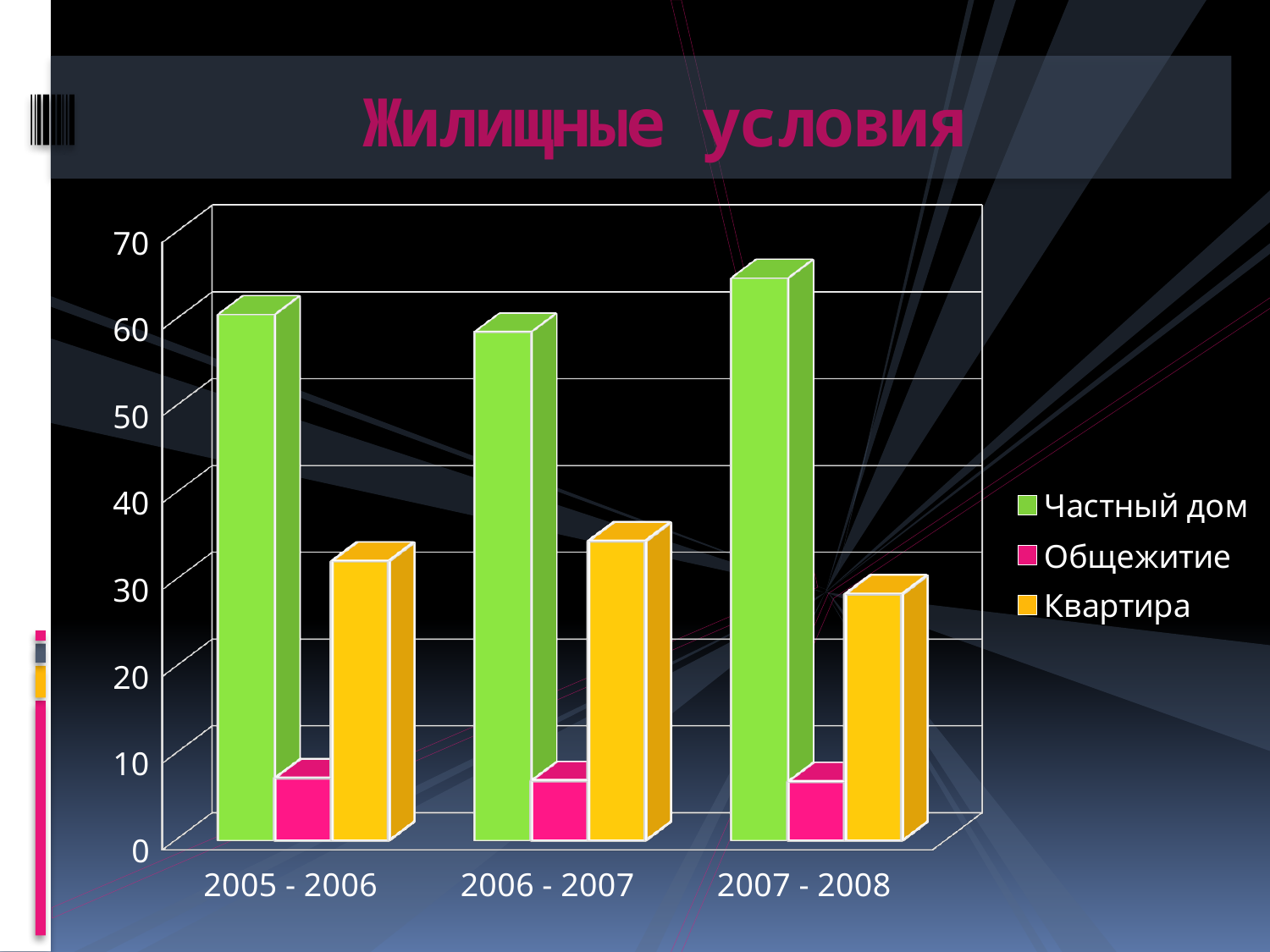
In which period is the value for Квартира the lowest? 2007 - 2008 What kind of chart is shown on the slide? bar chart Is the value for Квартира in 2006 - 2007 greater or less than 30? greater Is the value for Частный дом in 2007 - 2008 greater or less than 60? greater In which period is the value for Частный дом the highest? 2007 - 2008 How many categories are shown on the x axis? 3 How many series does the legend list? 3 Which series is shown in green? Частный дом Is the value for Общежитие in 2005 - 2006 greater or less than 10? less Which series has the lowest value in every period? Общежитие Which is larger in 2006 - 2007, Частный дом or Квартира? Частный дом What is the title of the chart? Жилищные условия